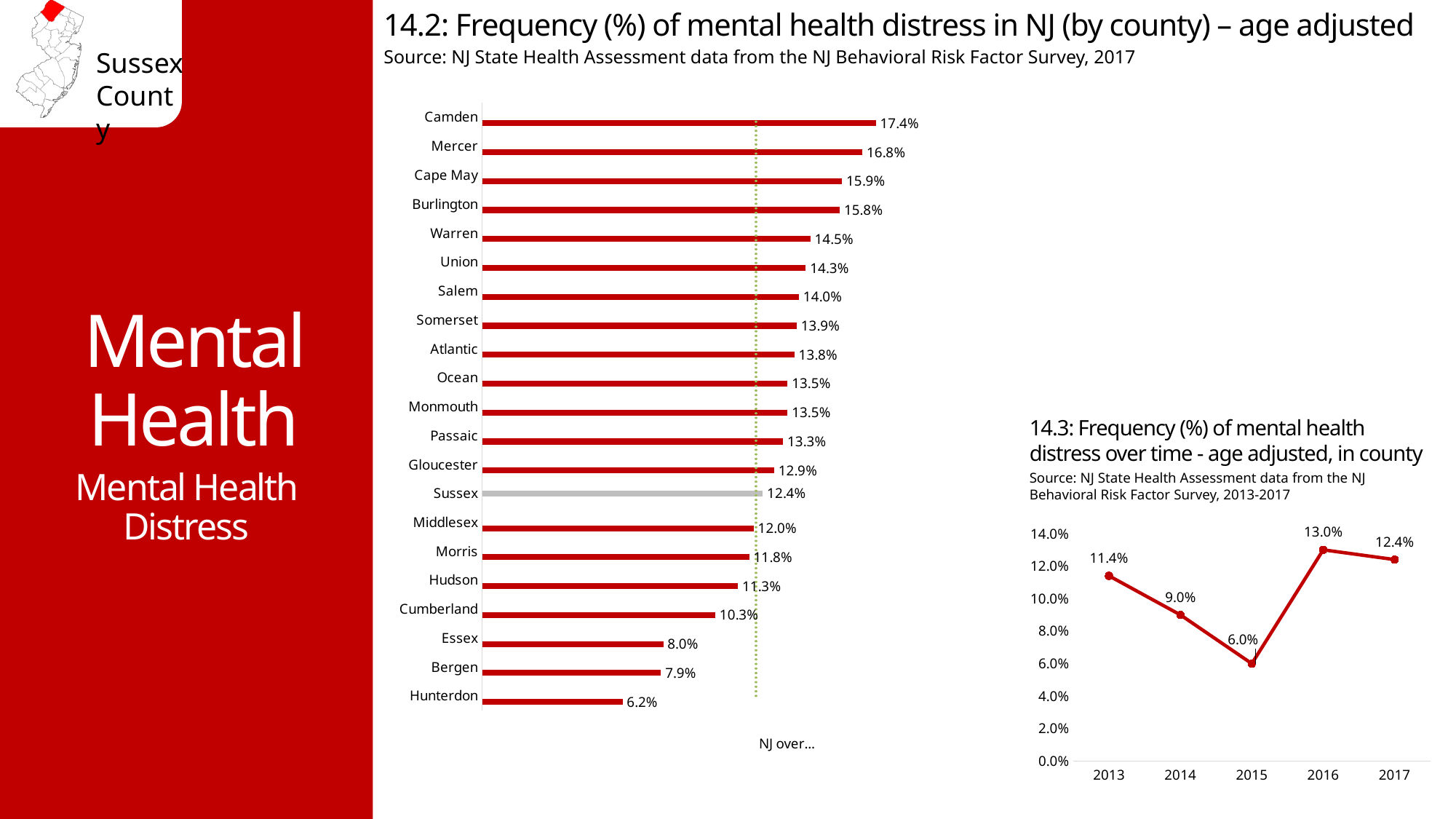
In the chart 14.2 (by county), which is larger, the value for Mercer or the value for Cape May? Mercer In the chart 14.2 (by county), how many counties are plotted? 21 In the chart 14.2 (by county), which county has the highest value? Camden In the chart 14.2 (by county), what is the difference between Camden and Hunterdon? 11.2% What kind of chart is chart 14.2 (by county)? Bar chart In the chart 14.3 (over time), which year has the highest value? 2016 In the chart 14.2 (by county), what is the value for Cumberland? 10.3% In the chart 14.3 (over time), what is the difference between the 2016 and 2017 values? 0.6% In the chart 14.3 (over time), how many years are plotted? 5 In the chart 14.2 (by county), what is the value for Sussex? 12.4% In the chart 14.3 (over time), what is the value for 2015? 6.0% In the chart 14.2 (by county), which county has the lowest value? Hunterdon